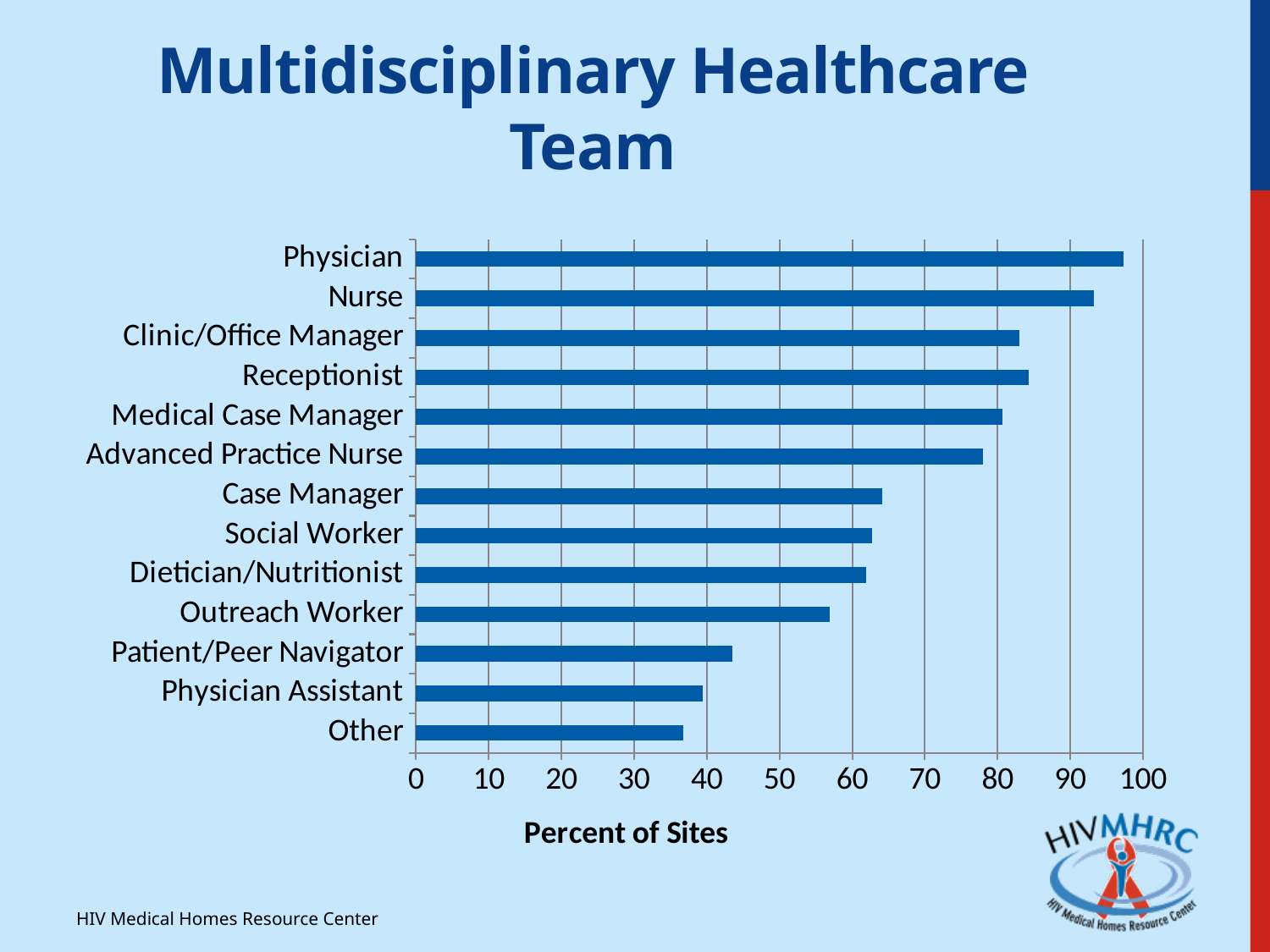
Is the value for Outreach Worker greater or less than 60? less Is the value for Case Manager greater or less than 60? greater How many categories (team roles) are plotted in the chart? 13 Which role has the highest percent of sites? Physician Which is larger, the value for Social Worker or the value for Patient/Peer Navigator? Social Worker Is the value for Physician greater or less than 90? greater Which is larger, the value for Nurse or the value for Medical Case Manager? Nurse What is the label of the horizontal axis? Percent of Sites Which role has the lowest percent of sites? Other What kind of chart is shown on the slide? bar chart